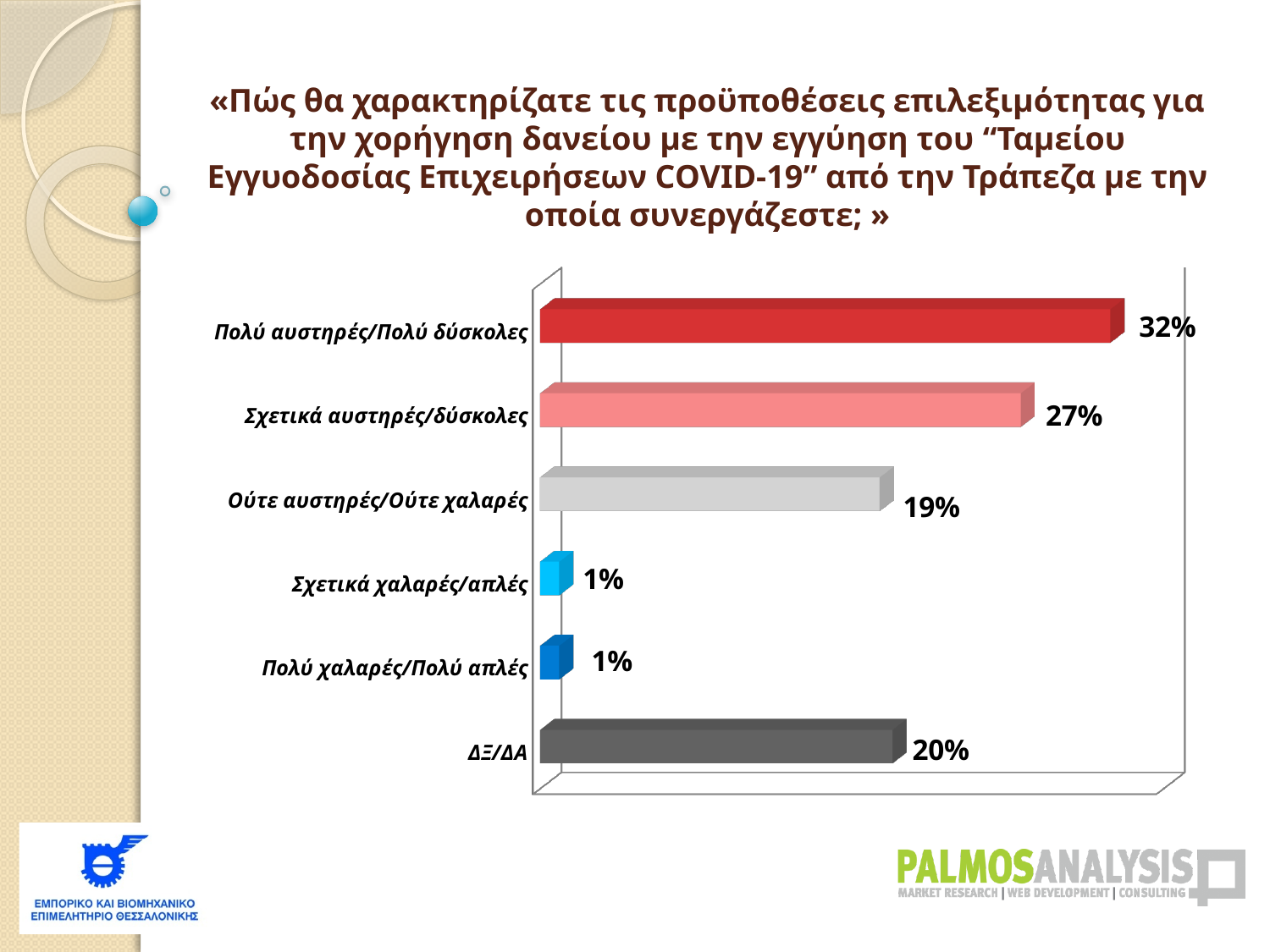
What is the value for "ΔΞ/ΔΑ"? 20% How many categories are shown in the chart? 6 What is the value for "Ούτε αυστηρές/Ούτε χαλαρές"? 19% What colour is the bar for "Πολύ αυστηρές/Πολύ δύσκολες"? Red What is the value for "Πολύ αυστηρές/Πολύ δύσκολες"? 32% What is the difference between the values for "Πολύ αυστηρές/Πολύ δύσκολες" and "Σχετικά αυστηρές/δύσκολες"? 5% What is the value for "Σχετικά αυστηρές/δύσκολες"? 27% What is the difference between the values for "ΔΞ/ΔΑ" and "Ούτε αυστηρές/Ούτε χαλαρές"? 1% What kind of chart is shown on the slide? Bar chart Which category has the highest value? Πολύ αυστηρές/Πολύ δύσκολες What is the value for "Σχετικά χαλαρές/απλές"? 1% Which is larger, the value for "Σχετικά αυστηρές/δύσκολες" or the value for "ΔΞ/ΔΑ"? Σχετικά αυστηρές/δύσκολες